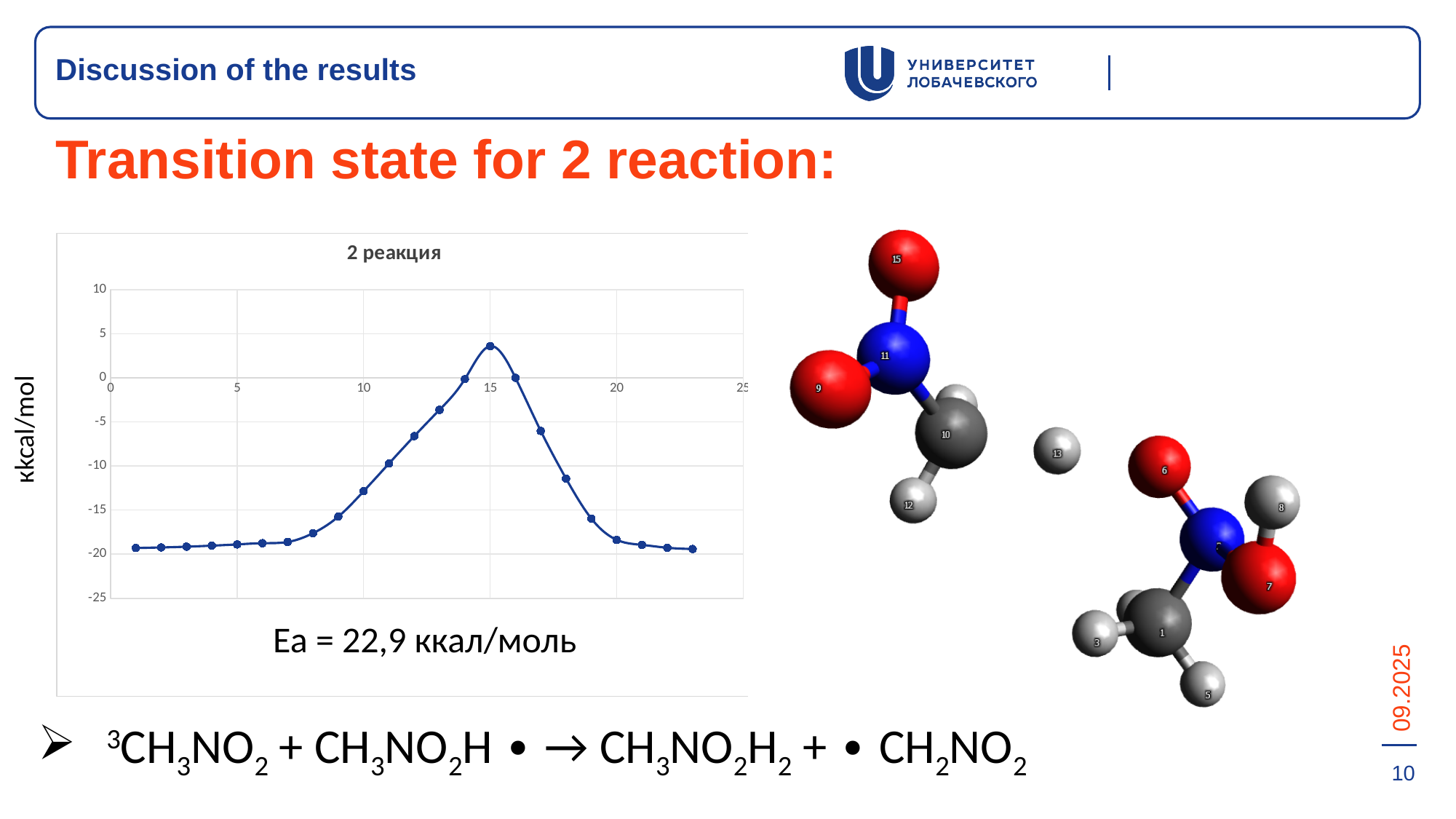
Do the values rise or fall along the x axis from x = 15 to x = 23? fall Is the value at x = 15 greater or less than 0? greater How many data points are plotted on the line? 23 What is the title of the chart? 2 реакция What is the label on the y axis of the chart? кkcal/mol Is the value at x = 10 greater or less than -10? less Which is larger, the value at x = 10 or the value at x = 12? x = 12 Is the value at x = 1 greater or less than -15? less At which x value does the line reach its highest point? 15 What kind of chart is shown on the slide? line chart